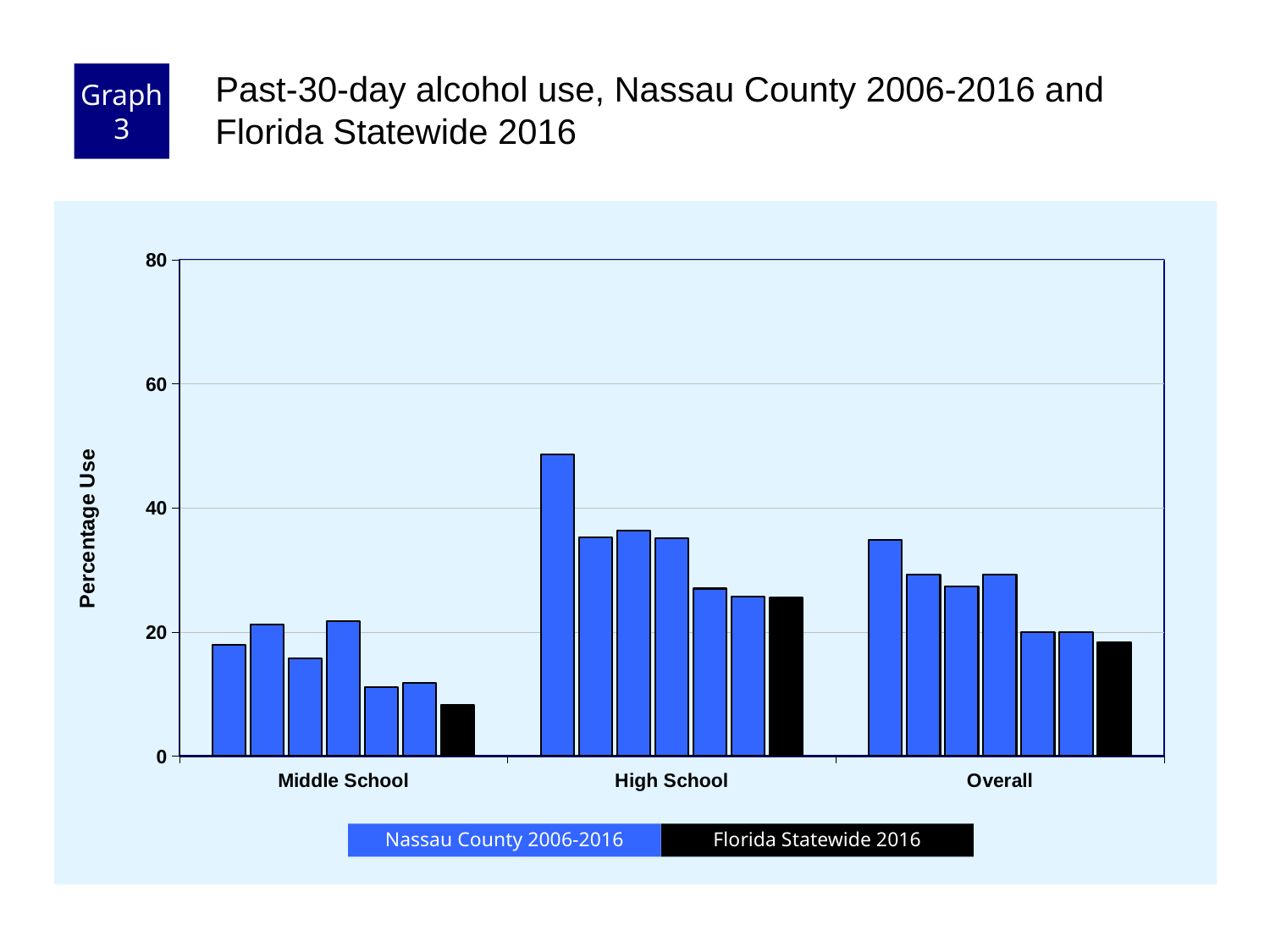
What kind of chart is shown on the slide? bar chart Is the Florida Statewide 2016 value for Middle School greater or less than 20? less Which colour represents Florida Statewide 2016 in the legend? black What is the label of the y axis? Percentage Use How many series does the legend list? 2 Within the High School group, do the Nassau County 2006-2016 bars generally rise or fall from left to right? fall Is the Florida Statewide 2016 value for Overall greater or less than 40? less Is the Florida Statewide 2016 value for High School greater or less than 20? greater How many categories are shown on the x axis? 3 Which category has the highest Florida Statewide 2016 value? High School Which category has the lowest Florida Statewide 2016 value? Middle School